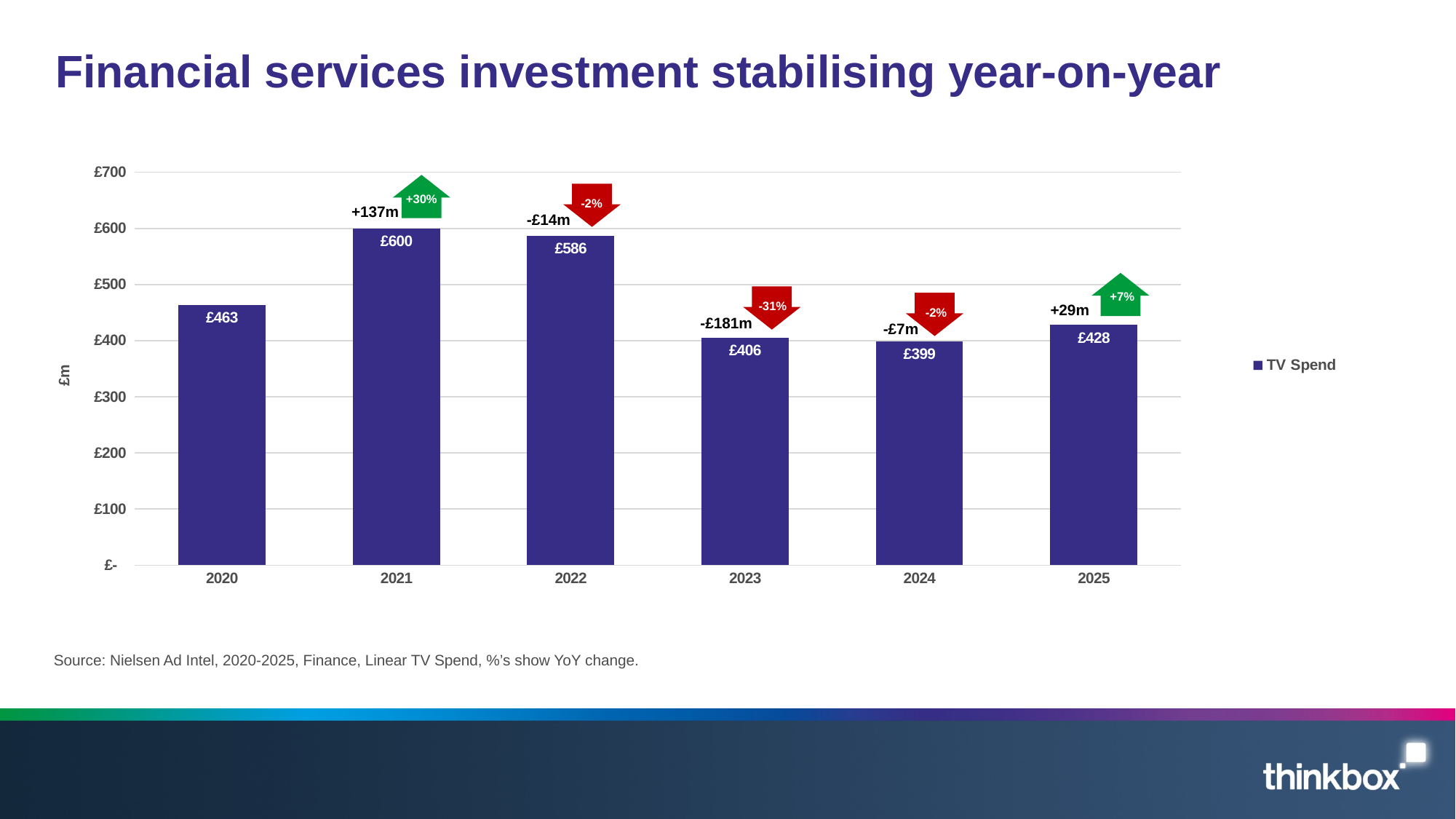
How many years are shown on the x axis? 6 What is the TV Spend value for 2023? £406 Is the TV Spend value for 2022 greater or less than £500? greater How many series does the legend list? 1 What kind of chart is shown on the slide? bar chart Which year has the lowest TV Spend? 2024 Which year has the highest TV Spend? 2021 What is the TV Spend value for 2020? £463 What year-on-year percentage change is shown above the 2023 bar? -31% What is the difference in TV Spend between 2021 and 2022? £14 Which year has a larger TV Spend, 2020 or 2025? 2020 What is the TV Spend value for 2025? £428